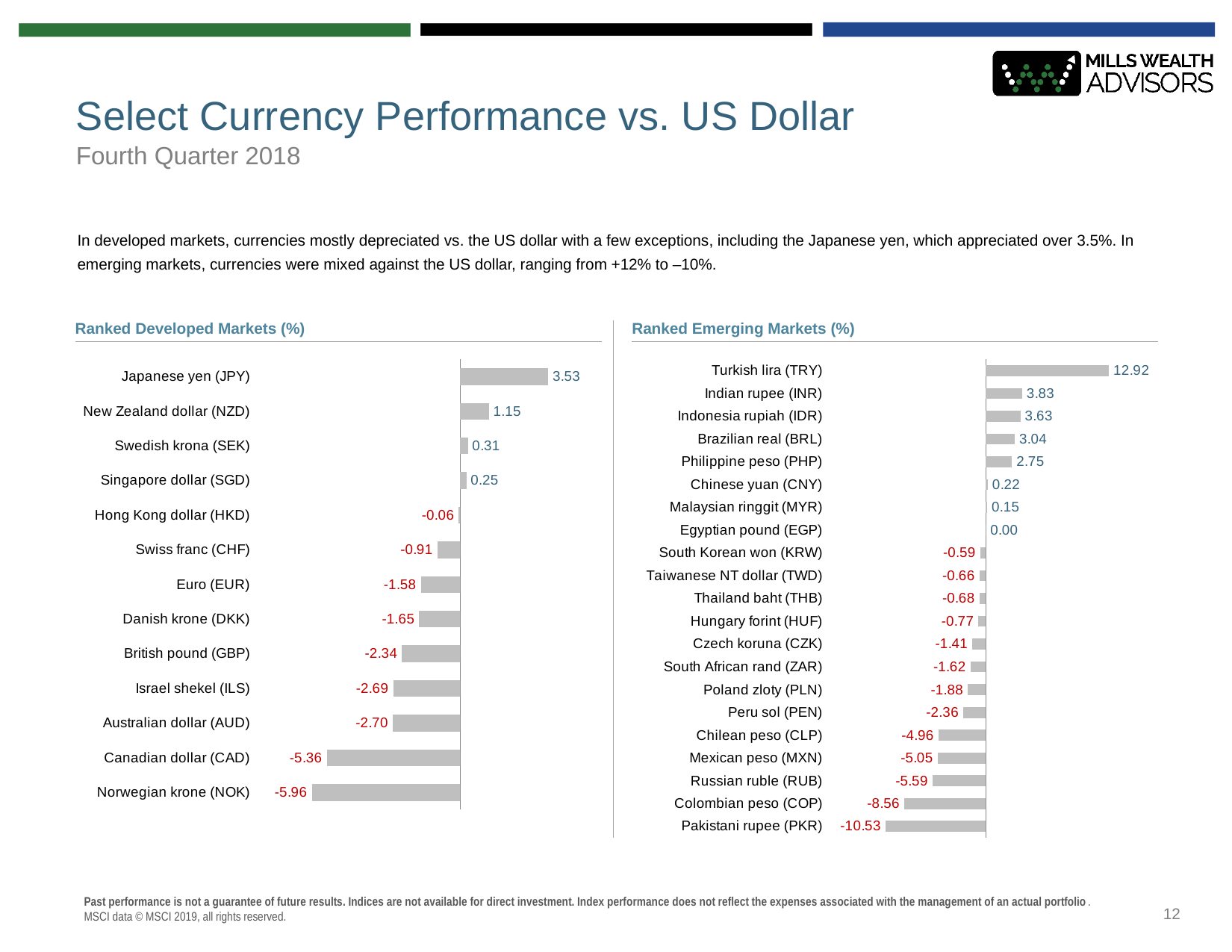
In the Ranked Emerging Markets (%) chart, how many currencies are shown? 21 In the Ranked Developed Markets (%) chart, which currency has the lowest value? Norwegian krone (NOK) In the Ranked Developed Markets (%) chart, what is the difference between the Japanese yen (JPY) and the New Zealand dollar (NZD)? 2.38 In the Ranked Emerging Markets (%) chart, what is the value for the Egyptian pound (EGP)? 0.00 In the Ranked Emerging Markets (%) chart, which currency has the lowest value? Pakistani rupee (PKR) In the Ranked Emerging Markets (%) chart, which is larger, the Indian rupee (INR) or the Brazilian real (BRL)? Indian rupee (INR) What type of chart is the Ranked Developed Markets (%) chart? Bar chart In the Ranked Emerging Markets (%) chart, what is the value for the Turkish lira (TRY)? 12.92 In the Ranked Developed Markets (%) chart, what is the value for the Japanese yen (JPY)? 3.53 In the Ranked Developed Markets (%) chart, how many currencies are shown? 13 In the Ranked Developed Markets (%) chart, what is the value for the Canadian dollar (CAD)? -5.36 In the Ranked Emerging Markets (%) chart, what is the difference between the Colombian peso (COP) and the Pakistani rupee (PKR)? 1.97